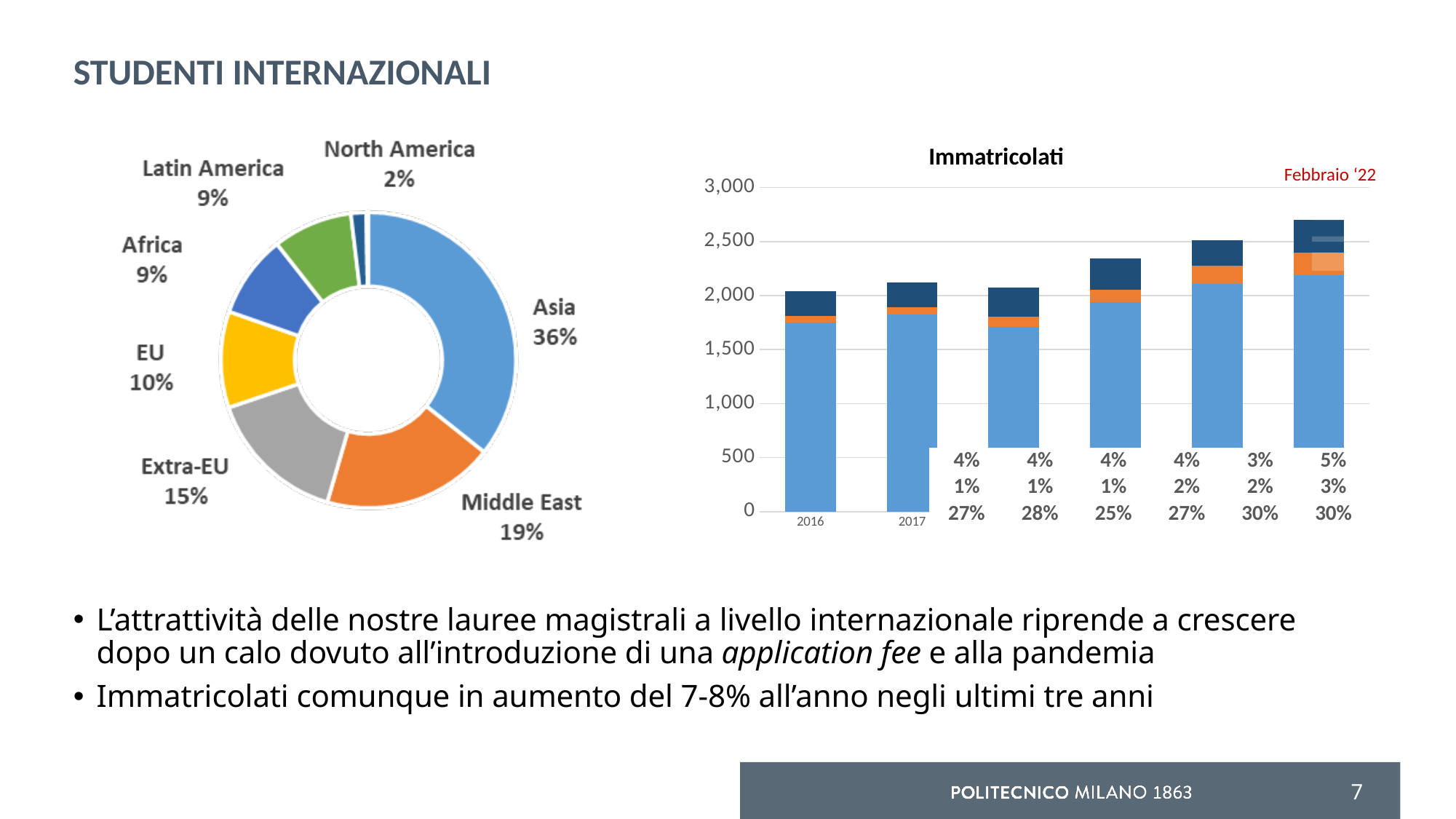
On the donut chart on the left, what is the difference in percentage points between Asia and Middle East? 17 How many regions are shown on the donut chart on the left? 7 On the 'Immatricolati' chart, do the bar totals generally rise or fall from the first bar to the last bar? rise On the 'Immatricolati' chart, is the total for 2017 greater or less than 2,000? greater On the donut chart on the left, which region has the largest share? Asia On the donut chart on the left, which is larger, the share for EU or the share for Extra-EU? Extra-EU On the donut chart on the left, which region has the smallest share? North America On the donut chart on the left, what percentage is shown for Middle East? 19% What kind of chart is the 'Immatricolati' chart on the right? Stacked bar chart On the donut chart on the left, what percentage is shown for Extra-EU? 15% What kind of chart is the chart on the left of the slide? Donut (pie) chart On the donut chart on the left, what share of international students comes from Asia? 36%